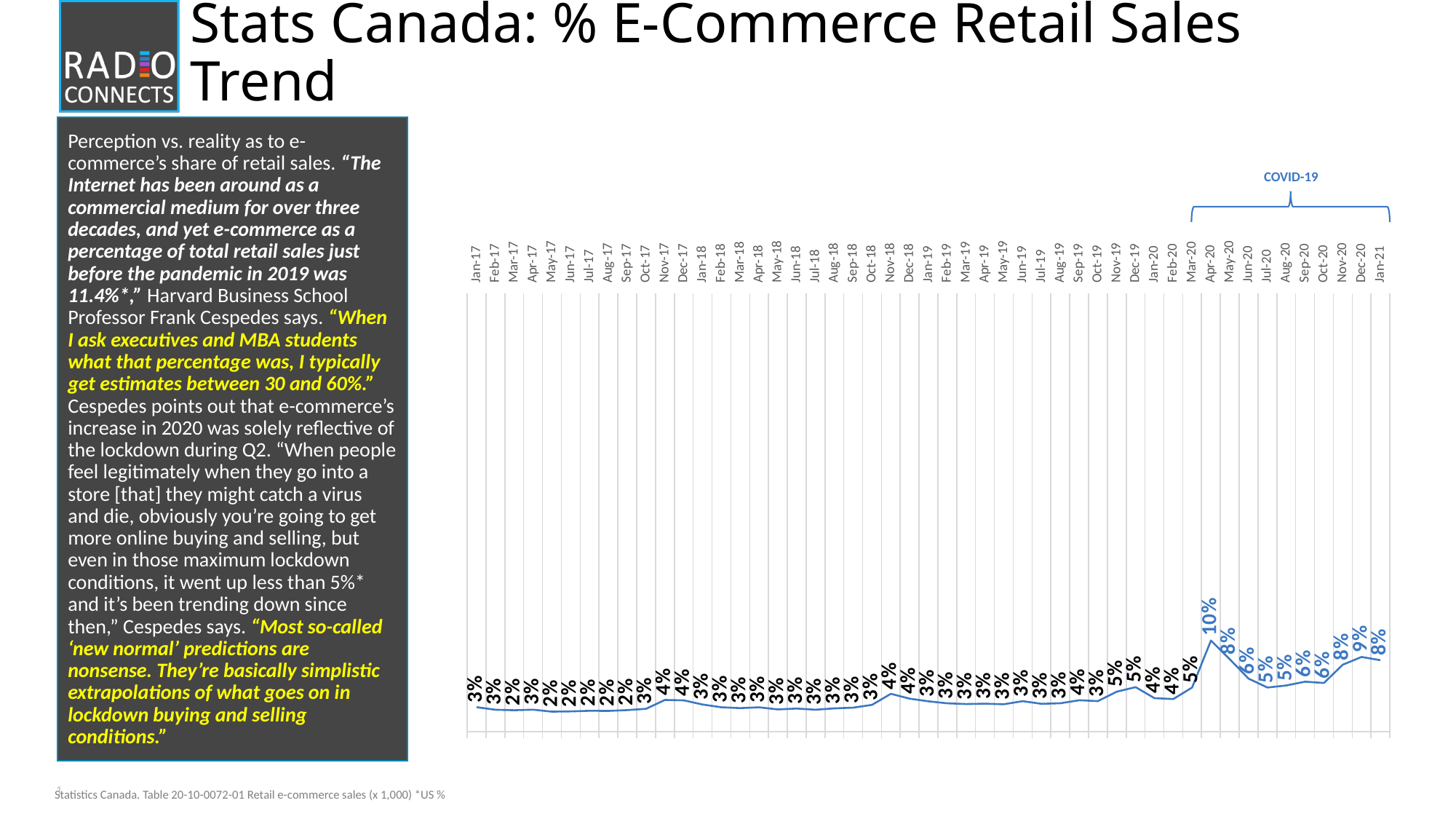
Which is larger, the value for Dec-20 or the value for Jan-21? Dec-20 What is the difference between the value for Apr-20 and the value for Jan-17? 7 percentage points What is the e-commerce share of retail sales for Apr-20? 10% What is the value shown for Jan-17? 3% What is the value shown for Dec-20? 9% What type of chart is shown on the slide? line chart What is the lowest value shown on the chart? 2% What is the value shown for Jan-21? 8% How many monthly data points are plotted on the chart? 49 Which month has the highest value on the chart? Apr-20 Do the values rise or fall from Apr-20 to Jul-20? fall What label is shown above the bracket marking the months from Mar-20 onward? COVID-19